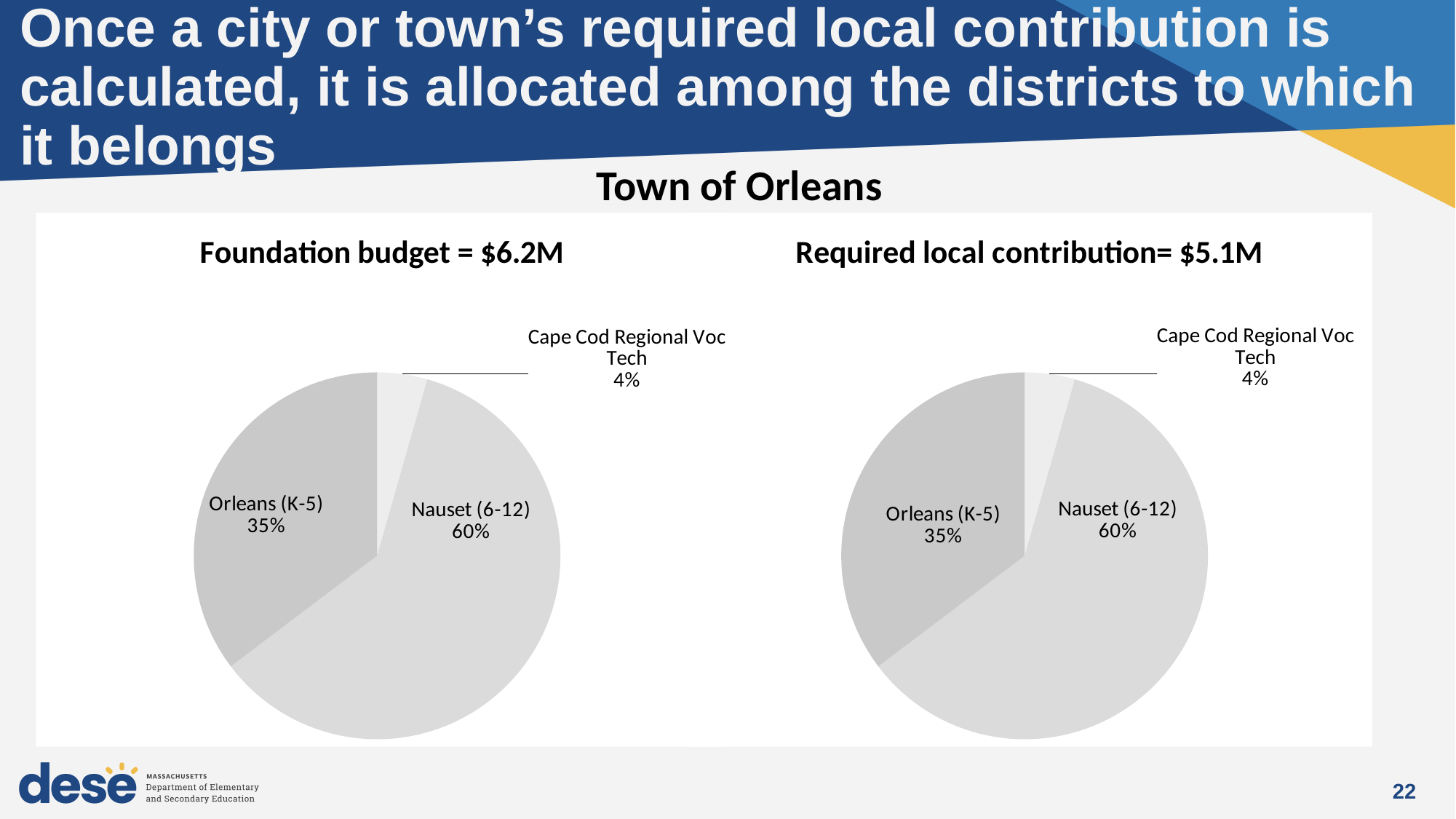
In the 'Foundation budget = $6.2M' chart, what is the difference in percentage points between Nauset (6-12) and Orleans (K-5)? 25 percentage points In the 'Foundation budget = $6.2M' chart, which district has the smallest slice? Cape Cod Regional Voc Tech How many slices does the 'Foundation budget = $6.2M' chart have? 3 In the 'Required local contribution= $5.1M' chart, what is the difference in percentage points between Orleans (K-5) and Cape Cod Regional Voc Tech? 31 percentage points In the 'Required local contribution= $5.1M' chart, what share does Orleans (K-5) have? 35% In the 'Required local contribution= $5.1M' chart, which district has the largest slice? Nauset (6-12) In the 'Required local contribution= $5.1M' chart, which is larger, the Orleans (K-5) slice or the Cape Cod Regional Voc Tech slice? Orleans (K-5) What type of chart is the 'Required local contribution= $5.1M' chart? Pie chart In the 'Foundation budget = $6.2M' chart, what share does Nauset (6-12) have? 60% What is the title of the chart on the right side of the slide? Required local contribution= $5.1M In the 'Foundation budget = $6.2M' chart, what share does Cape Cod Regional Voc Tech have? 4% How many charts are shown on the slide? 2